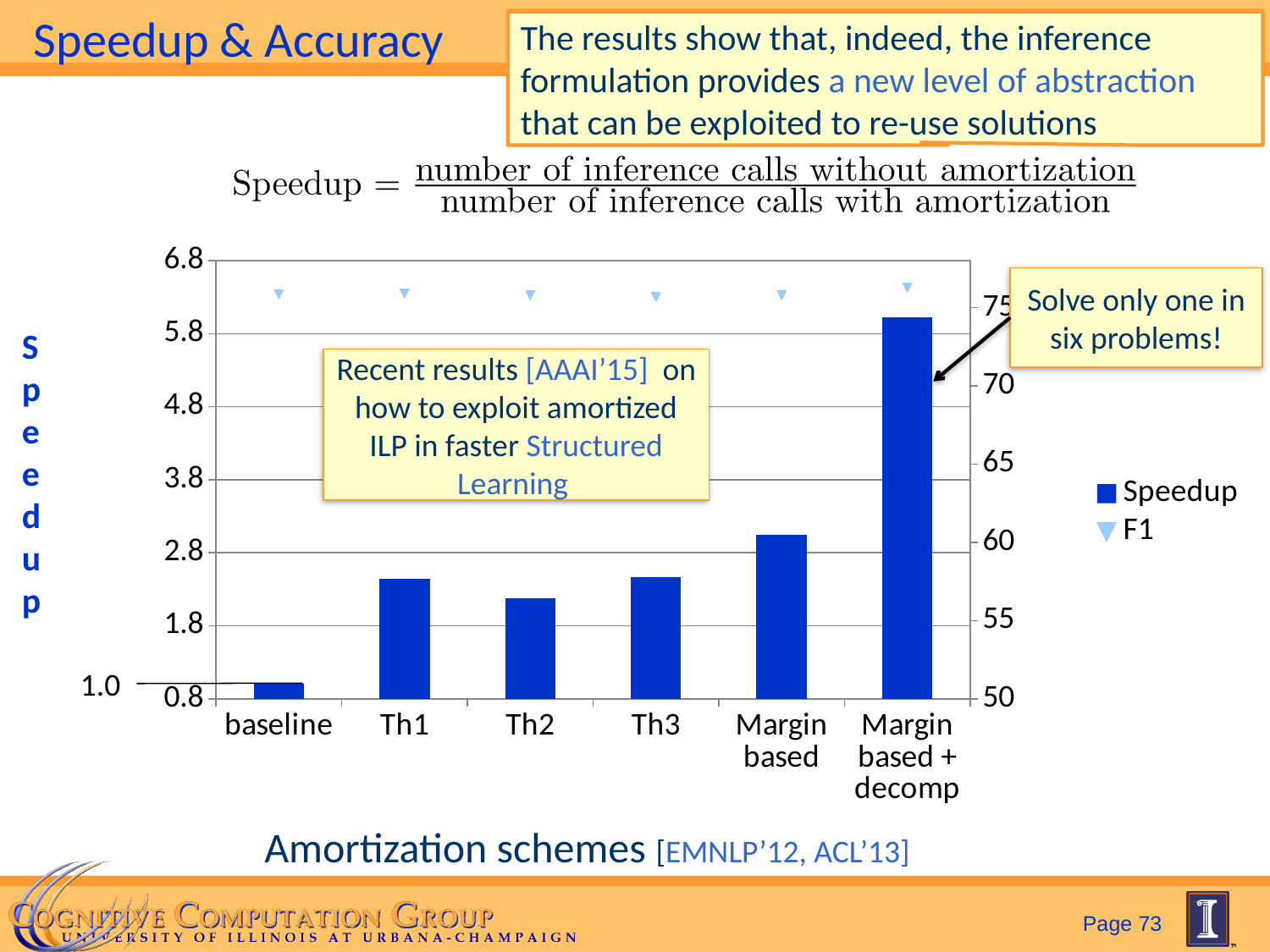
Is the Speedup for Th2 greater or less than 1.8? greater Which amortization scheme has the lowest Speedup? baseline Is the Speedup for Margin based + decomp greater or less than 4.8? greater How many series does the legend list? 2 Is the Speedup for Margin based greater or less than 3.8? less How many amortization schemes are shown on the x axis? 6 Which has a larger Speedup, Margin based or Th1? Margin based Which has a larger Speedup, Margin based + decomp or Margin based? Margin based + decomp What kind of chart is used to show Speedup? bar chart Which amortization scheme has the highest Speedup? Margin based + decomp What are the two entries in the chart legend? Speedup and F1